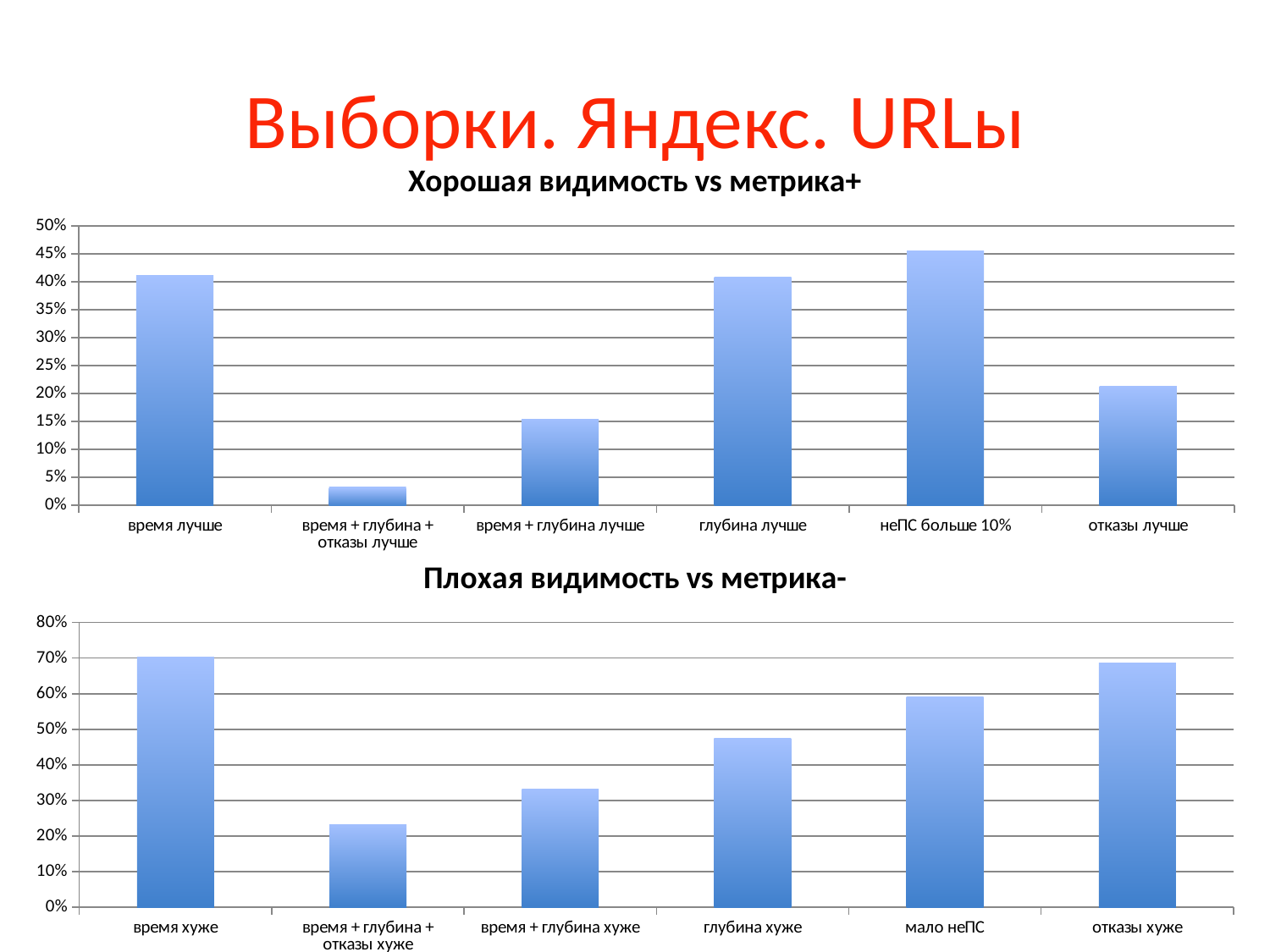
What is the title of the bottom chart on the slide? Плохая видимость vs метрика- In the bottom chart "Плохая видимость vs метрика-", which is larger: "глубина хуже" or "время + глубина хуже"? глубина хуже In the top chart "Хорошая видимость vs метрика+", is the value for "время + глубина лучше" greater or less than 20%? less In the top chart "Хорошая видимость vs метрика+", is the value for "отказы лучше" greater or less than 20%? greater In the top chart "Хорошая видимость vs метрика+", which is larger: "время лучше" or "отказы лучше"? время лучше What kind of chart is the top chart titled "Хорошая видимость vs метрика+"? bar chart How many categories are shown in the bottom chart "Плохая видимость vs метрика-"? 6 In the bottom chart "Плохая видимость vs метрика-", which category has the lowest value? время + глубина + отказы хуже In the top chart "Хорошая видимость vs метрика+", which category has the highest value? неПС больше 10% In the bottom chart "Плохая видимость vs метрика-", is the value for "мало неПС" greater or less than 50%? greater How many categories are shown in the top chart "Хорошая видимость vs метрика+"? 6 In the top chart "Хорошая видимость vs метрика+", which category has the lowest value? время + глубина + отказы лучше